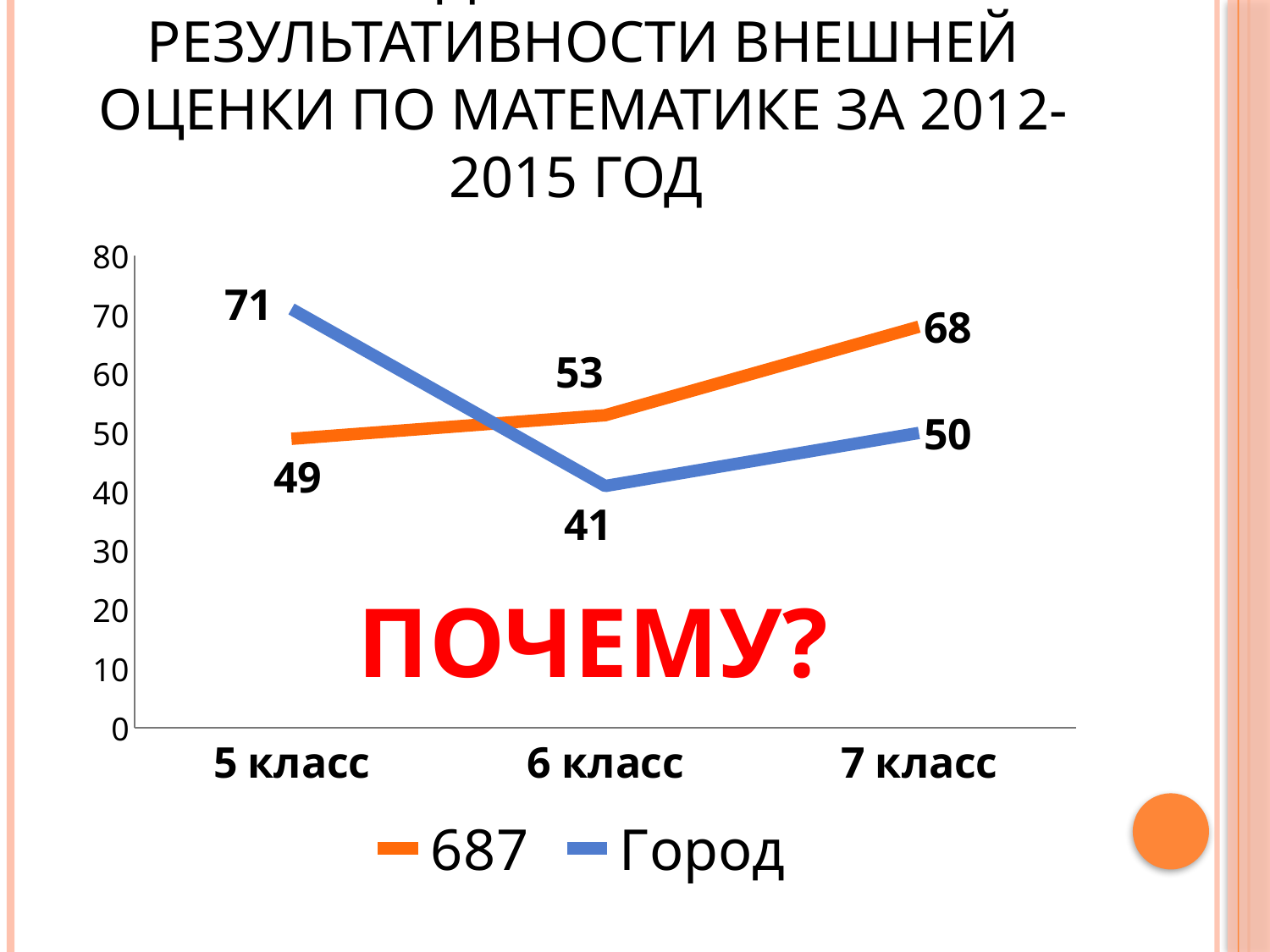
How many series does the legend list? 2 What is the value for Город at 6 класс? 41 What is the value for 687 at 7 класс? 68 How many classes are shown on the x axis? 3 Which series has the larger value at 5 класс, 687 or Город? Город What is the difference between 687 and Город at 7 класс? 18 What is the value for 687 at 5 класс? 49 What is the value for Город at 5 класс? 71 At which class is the value for 687 highest? 7 класс At which class is the value for Город lowest? 6 класс Does the value for 687 rise or fall from 5 класс to 7 класс? rise What kind of chart is shown on the slide? line chart